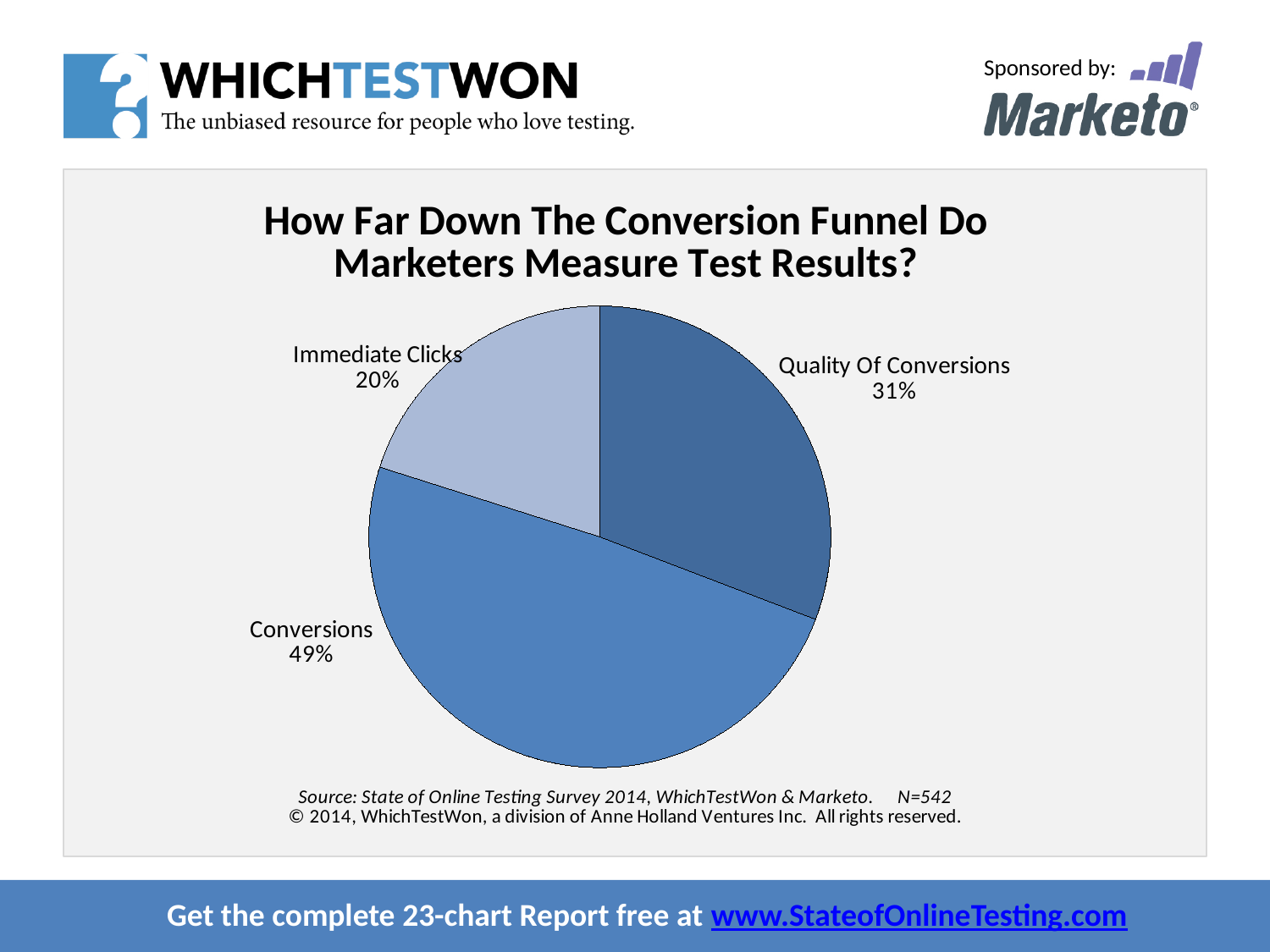
What percentage of marketers measure test results at Conversions? 49% What is the title of the chart? How Far Down The Conversion Funnel Do Marketers Measure Test Results? Which is larger, the share for Quality Of Conversions or the share for Immediate Clicks? Quality Of Conversions What percentage of marketers measure test results at Immediate Clicks? 20% What percentage of marketers measure test results at Quality Of Conversions? 31% Which category has the smallest share of the pie? Immediate Clicks What is the difference in percentage points between Conversions and Quality Of Conversions? 18 How many categories are shown in the pie chart? 3 What is the difference in percentage points between Quality Of Conversions and Immediate Clicks? 11 Which category has the largest share of the pie? Conversions What kind of chart is shown on the slide? Pie chart What is the sample size (N) stated in the chart's source note? 542